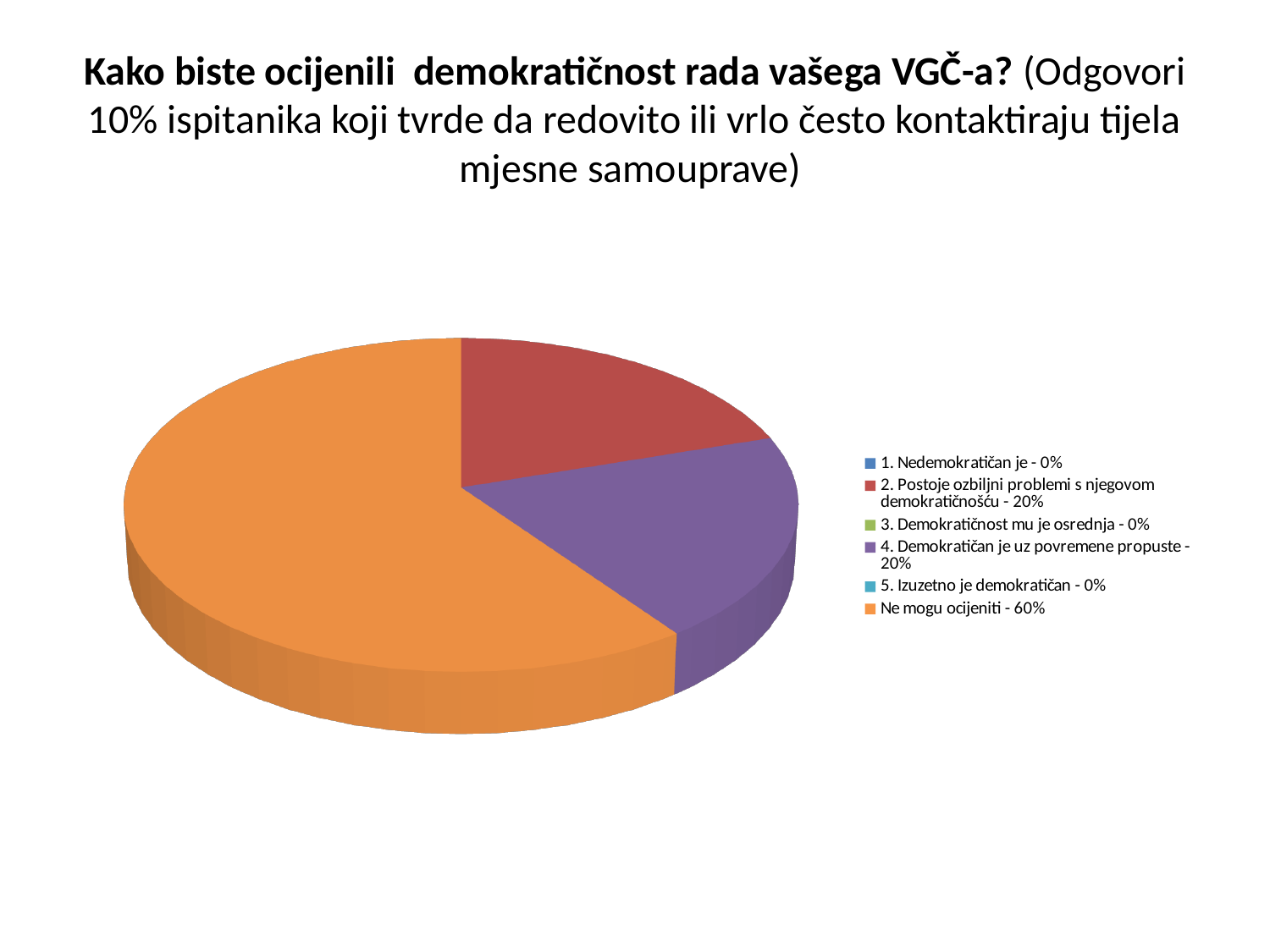
What share of respondents answered "1. Nedemokratičan je"? 0% Which answer category has the largest share of the pie? Ne mogu ocijeniti What share of respondents answered "4. Demokratičan je uz povremene propuste"? 20% Which is larger: the share for "Ne mogu ocijeniti" or the share for "2. Postoje ozbiljni problemi s njegovom demokratičnošću"? Ne mogu ocijeniti What is the difference in percentage points between "Ne mogu ocijeniti" and "4. Demokratičan je uz povremene propuste"? 40 percentage points How many answer categories does the legend list? 6 What kind of chart is shown on the slide? pie chart What share of respondents answered "2. Postoje ozbiljni problemi s njegovom demokratičnošću"? 20% What colour is the slice for "Ne mogu ocijeniti"? orange How many legend categories have a share of 0%? 3